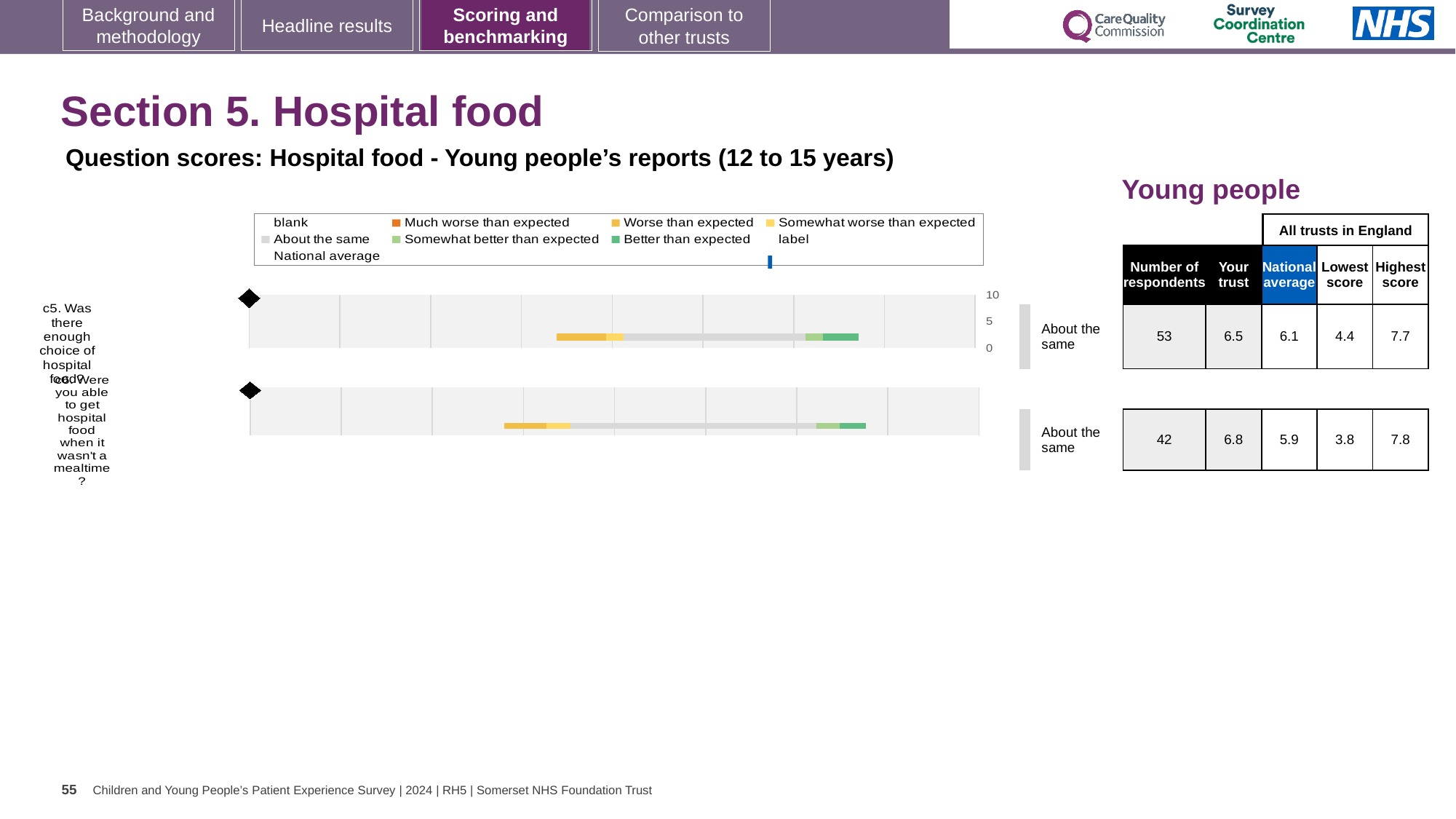
Which legend entry is shown in dark orange? Much worse than expected Which question has the higher 'Your trust' score, c5 or c6? c6 What is the 'Your trust' score for question c5 (Was there enough choice of hospital food?)? 6.5 How many questions (categories) are plotted in the hospital food chart? 2 How is the trust's result for question c5 rated relative to other trusts? About the same What is the difference between the 'Your trust' score and the national average for question c6? 0.9 How many respondents answered question c5 (Was there enough choice of hospital food?)? 53 What is the national average score for question c6 (Were you able to get hospital food when it wasn't a mealtime?)? 5.9 What is the maximum value shown on the chart's score axis? 10 What is the highest score among all trusts in England for question c5? 7.7 What kind of chart is used to show the question scores for c5 and c6? bar chart What is the lowest score among all trusts in England for question c6? 3.8